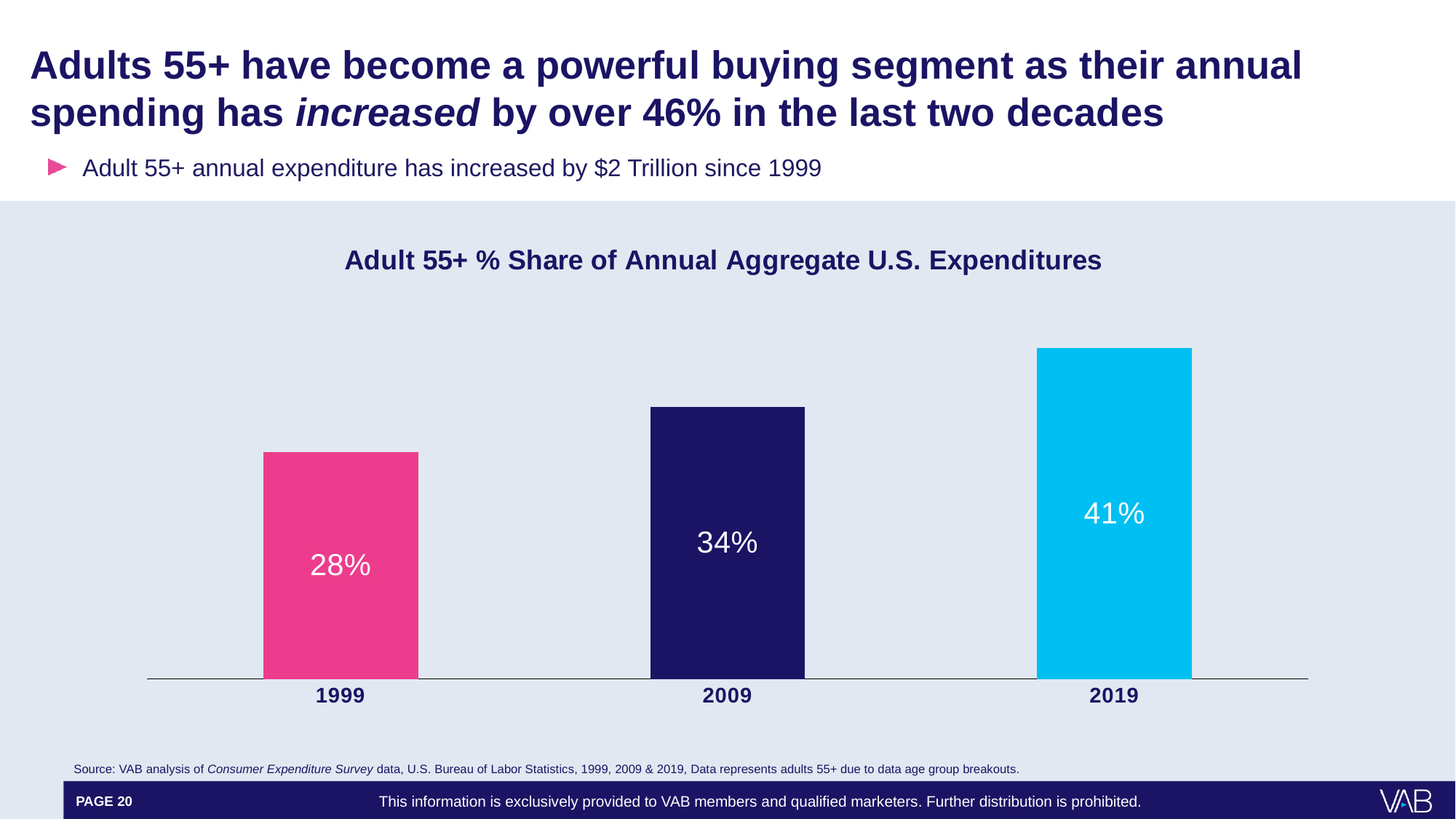
Which year has the lowest Adult 55+ share of annual aggregate U.S. expenditures? 1999 How many years are shown in the chart? 3 Which year has the highest Adult 55+ share of annual aggregate U.S. expenditures? 2019 What is the Adult 55+ share of annual aggregate U.S. expenditures in 1999? 28% What type of chart is used to show the Adult 55+ share of annual aggregate U.S. expenditures? Bar chart What is the difference between the 2009 and 1999 Adult 55+ share values? 6 percentage points Do the values in the chart rise or fall from 1999 to 2019? Rise Is the Adult 55+ share of expenditures larger in 2009 or in 2019? 2019 What is the title of the chart? Adult 55+ % Share of Annual Aggregate U.S. Expenditures By how many percentage points did the Adult 55+ share of expenditures increase from 1999 to 2019? 13 percentage points What is the Adult 55+ share of annual aggregate U.S. expenditures in 2019? 41% What is the Adult 55+ share of annual aggregate U.S. expenditures in 2009? 34%